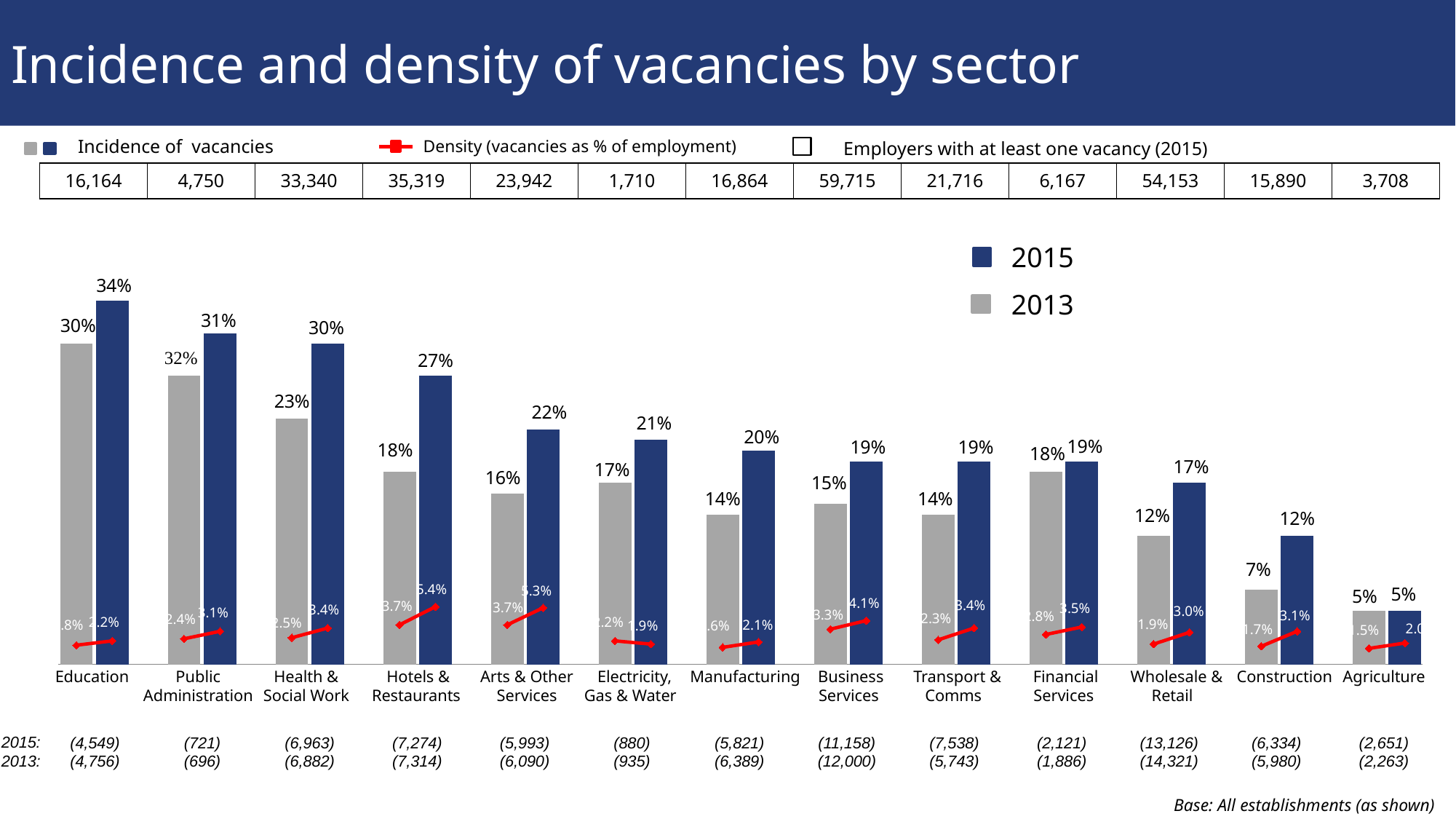
Which sector has the lowest incidence of vacancies in 2013? Agriculture By how many percentage points did the incidence of vacancies in Health & Social Work change from 2013 to 2015? 7 percentage points According to the table row, how many employers in Business Services had at least one vacancy in 2015? 59,715 What type of chart is used to show the incidence of vacancies? Bar chart What is the 2015 incidence of vacancies for Hotels & Restaurants? 27% How many series does the legend in the chart list? 2 Which sector has the highest incidence of vacancies in 2015? Education What is the incidence of vacancies for Education in 2015? 34% What is the difference between the 2015 and 2013 incidence of vacancies for Construction? 5 percentage points What is the incidence of vacancies for Public Administration in 2013? 32% How many sectors are shown on the x axis of the chart? 13